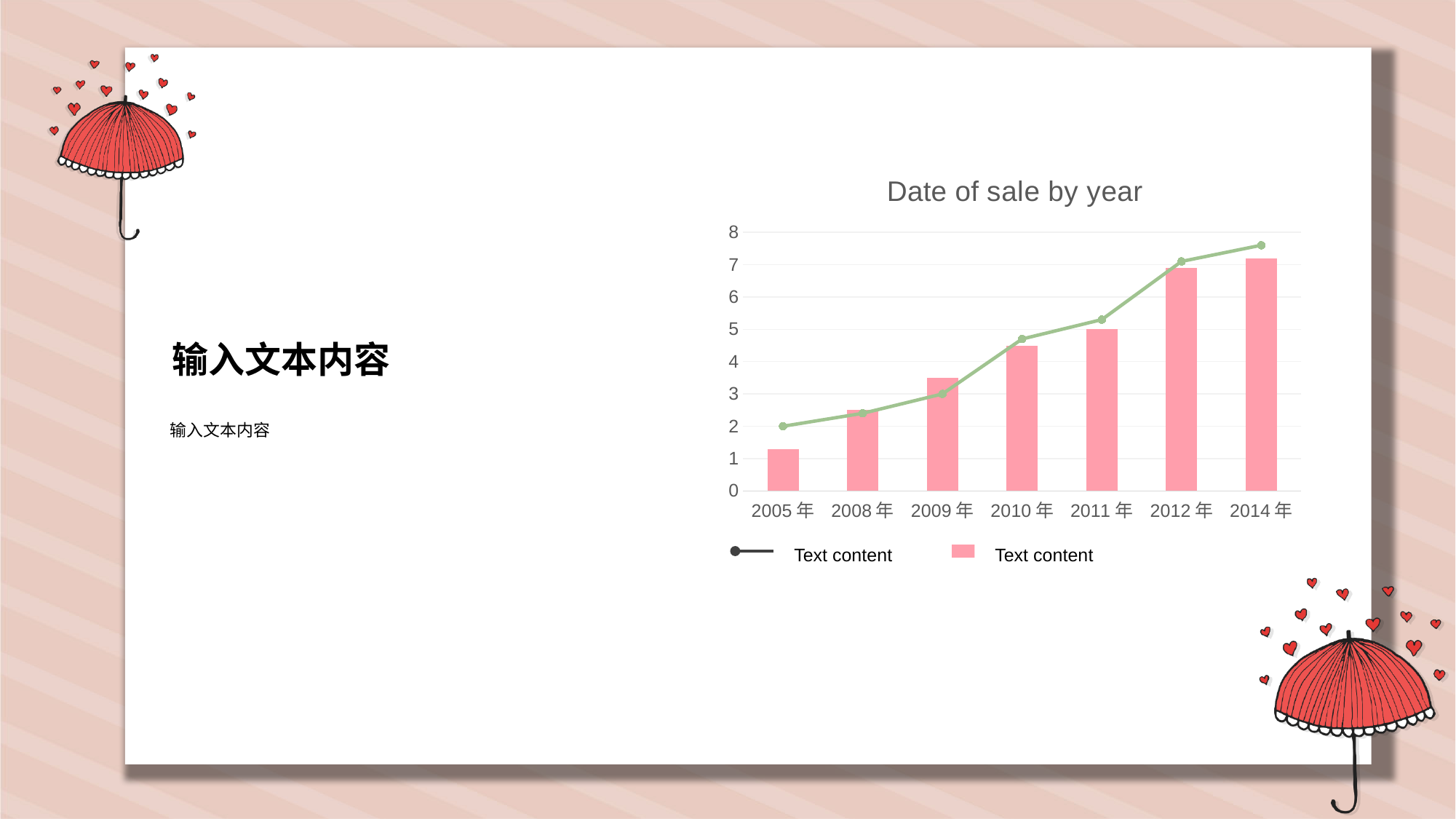
What is the title of the chart? Date of sale by year Is the line value for 2010 年 greater or less than 4? greater How many series does the chart's legend list? 2 Do the bar values rise or fall from 2005 年 to 2014 年? rise How many year categories are shown on the x axis of the chart? 7 Which year has the shortest bar in the chart? 2005 年 Which year has the taller bar, 2009 年 or 2011 年? 2011 年 What kind of chart is shown on the slide? A combined bar and line chart Is the line value for 2014 年 greater or less than 7? greater Which year has the tallest bar in the chart? 2014 年 Is the bar value for 2012 年 greater or less than 6? greater